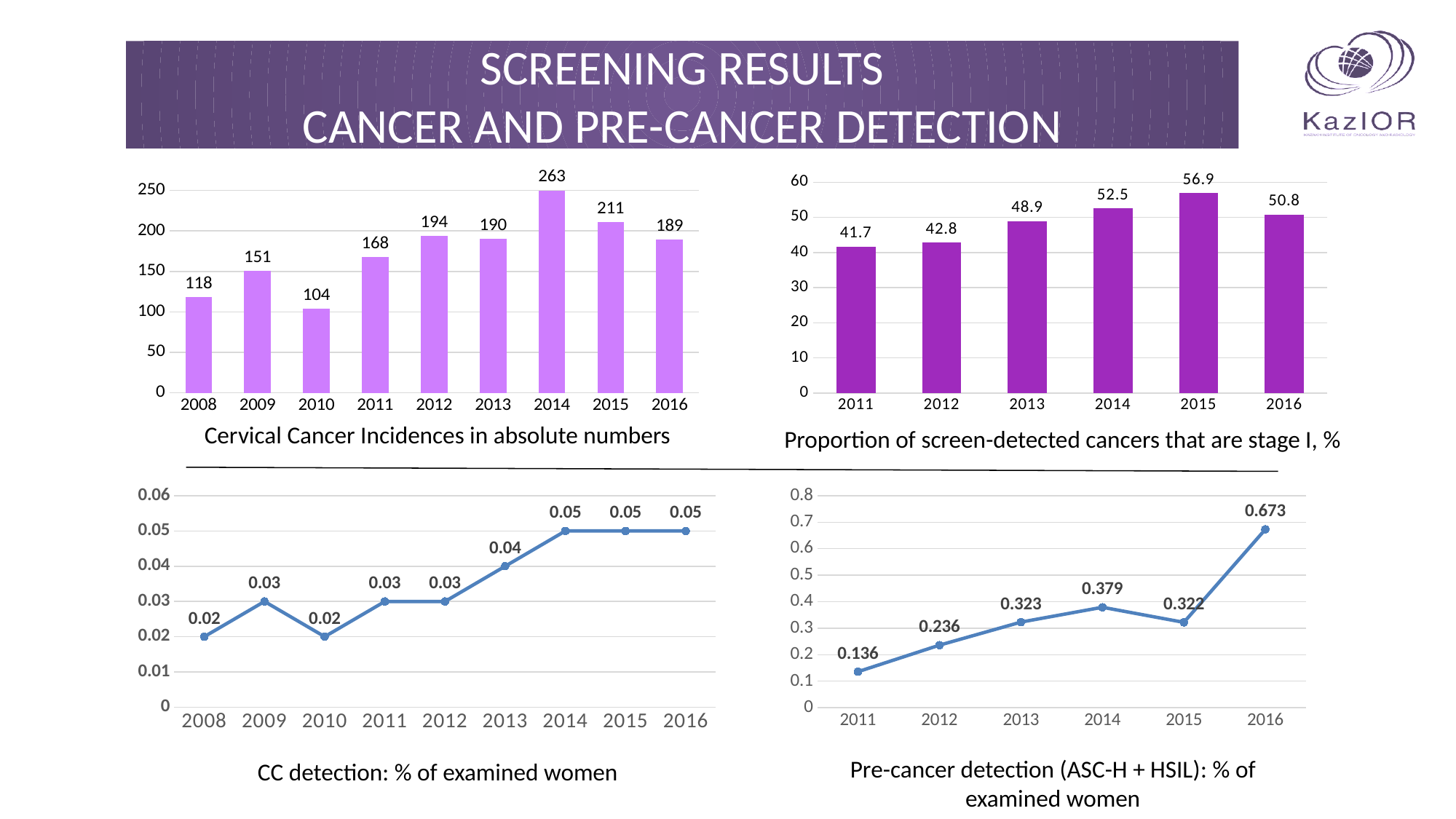
In the 'Cervical Cancer Incidences in absolute numbers' chart, what is the difference between the values for 2015 and 2016? 22 What kind of chart is the 'Proportion of screen-detected cancers that are stage I, %' chart? Bar chart In the 'Pre-cancer detection (ASC-H + HSIL): % of examined women' chart, what is the difference between the values for 2014 and 2015? 0.057 In the 'Cervical Cancer Incidences in absolute numbers' chart, what is the value for 2014? 263 In the 'Proportion of screen-detected cancers that are stage I, %' chart, what is the value for 2013? 48.9 In the 'Proportion of screen-detected cancers that are stage I, %' chart, which year has the highest value? 2015 In the 'Pre-cancer detection (ASC-H + HSIL): % of examined women' chart, what is the value for 2016? 0.673 In the 'Cervical Cancer Incidences in absolute numbers' chart, which year has the lowest value? 2010 How many years are shown in the 'Cervical Cancer Incidences in absolute numbers' chart? 9 What kind of chart is the 'CC detection: % of examined women' chart? Line chart In the 'Proportion of screen-detected cancers that are stage I, %' chart, is the value for 2014 larger than the value for 2016? Yes In the 'CC detection: % of examined women' chart, what is the value for 2013? 0.04